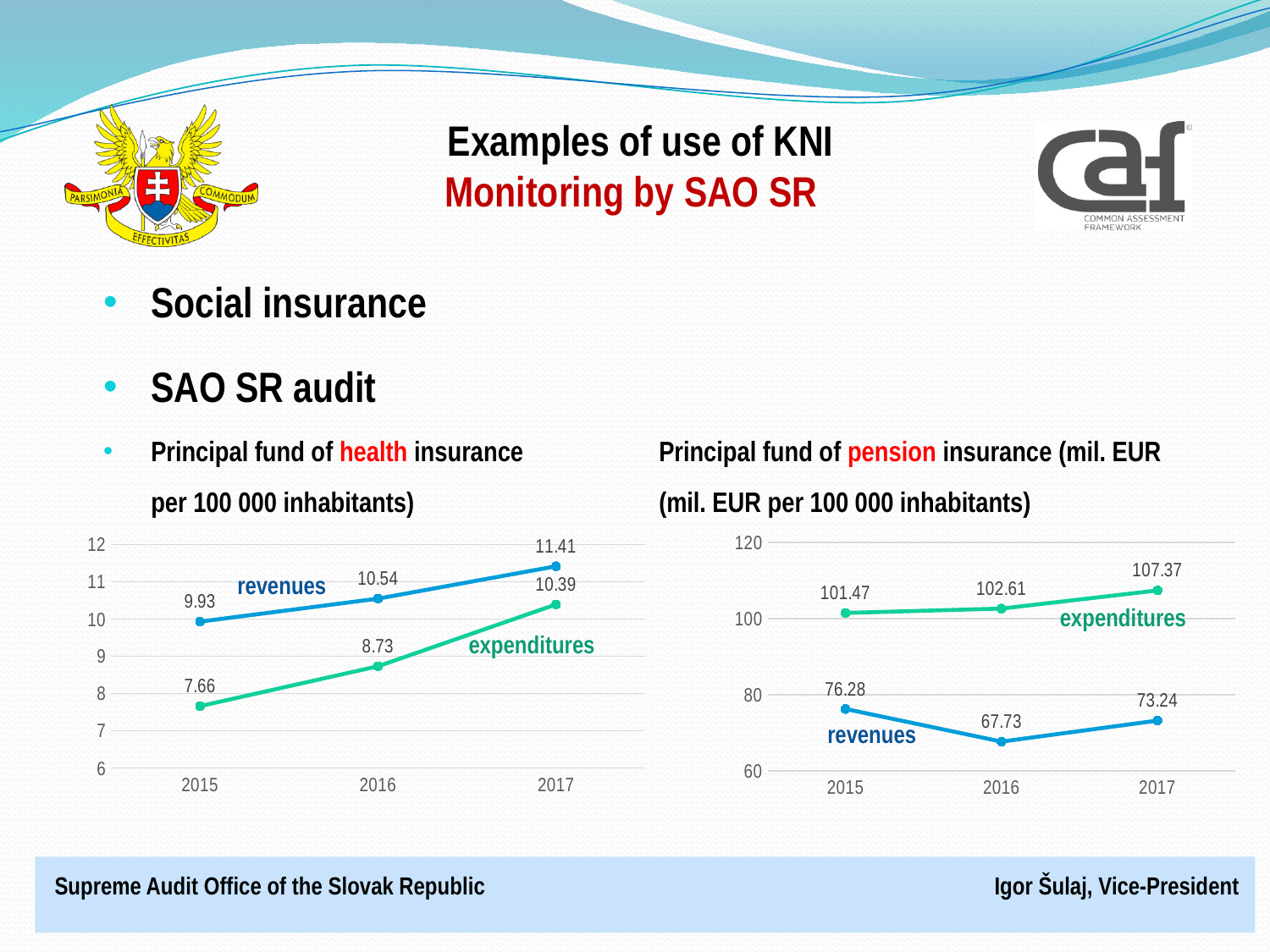
In the health insurance chart on the left, what is the difference between revenues and expenditures in 2017? 1.02 In the pension insurance chart on the right, what is the difference between expenditures and revenues in 2015? 25.19 In the health insurance chart on the left, in which year are expenditures highest? 2017 In the health insurance chart on the left, what is the value of revenues in 2016? 10.54 In the pension insurance chart on the right, in which year are revenues lowest? 2016 How many years are shown on the x axis of the pension insurance chart on the right? 3 What type of chart is the health insurance chart on the left? line chart In the pension insurance chart on the right, which is larger in 2016, revenues or expenditures? expenditures In the pension insurance chart on the right, what is the value of expenditures in 2017? 107.37 In the health insurance chart on the left, do revenues rise or fall from 2015 to 2017? rise In the health insurance chart on the left, what is the value of expenditures in 2015? 7.66 In the pension insurance chart on the right, what is the value of revenues in 2016? 67.73